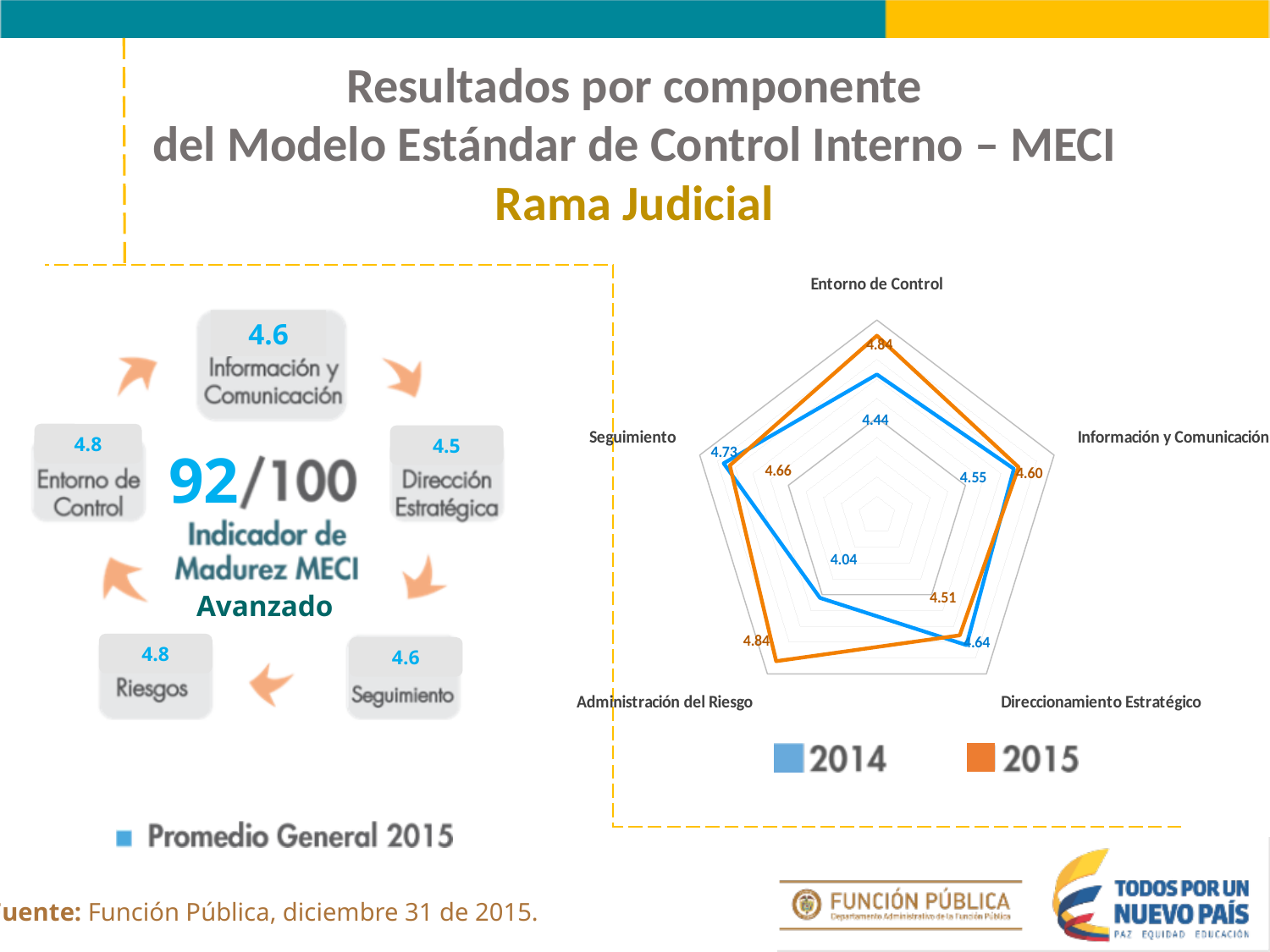
In the radar chart, what is the difference between the 2015 and 2014 values for Administración del Riesgo? 0.80 In the radar chart, what is the 2014 value for Seguimiento? 4.73 How many series does the legend of the radar chart list? 2 In the radar chart, what is the 2015 value for Entorno de Control? 4.84 In the radar chart, which is larger for Direccionamiento Estratégico: the 2014 value or the 2015 value? 2014 In the radar chart, which component has the lowest 2014 value? Administración del Riesgo In the radar chart, what is the 2014 value for Administración del Riesgo? 4.04 How many components (axes) does the radar chart have? 5 What kind of chart is shown on the right side of the slide? radar chart In the radar chart, which component has the lowest 2015 value? Direccionamiento Estratégico In the radar chart, what is the 2015 value for Direccionamiento Estratégico? 4.51 Which colour represents the 2015 series in the radar chart? orange